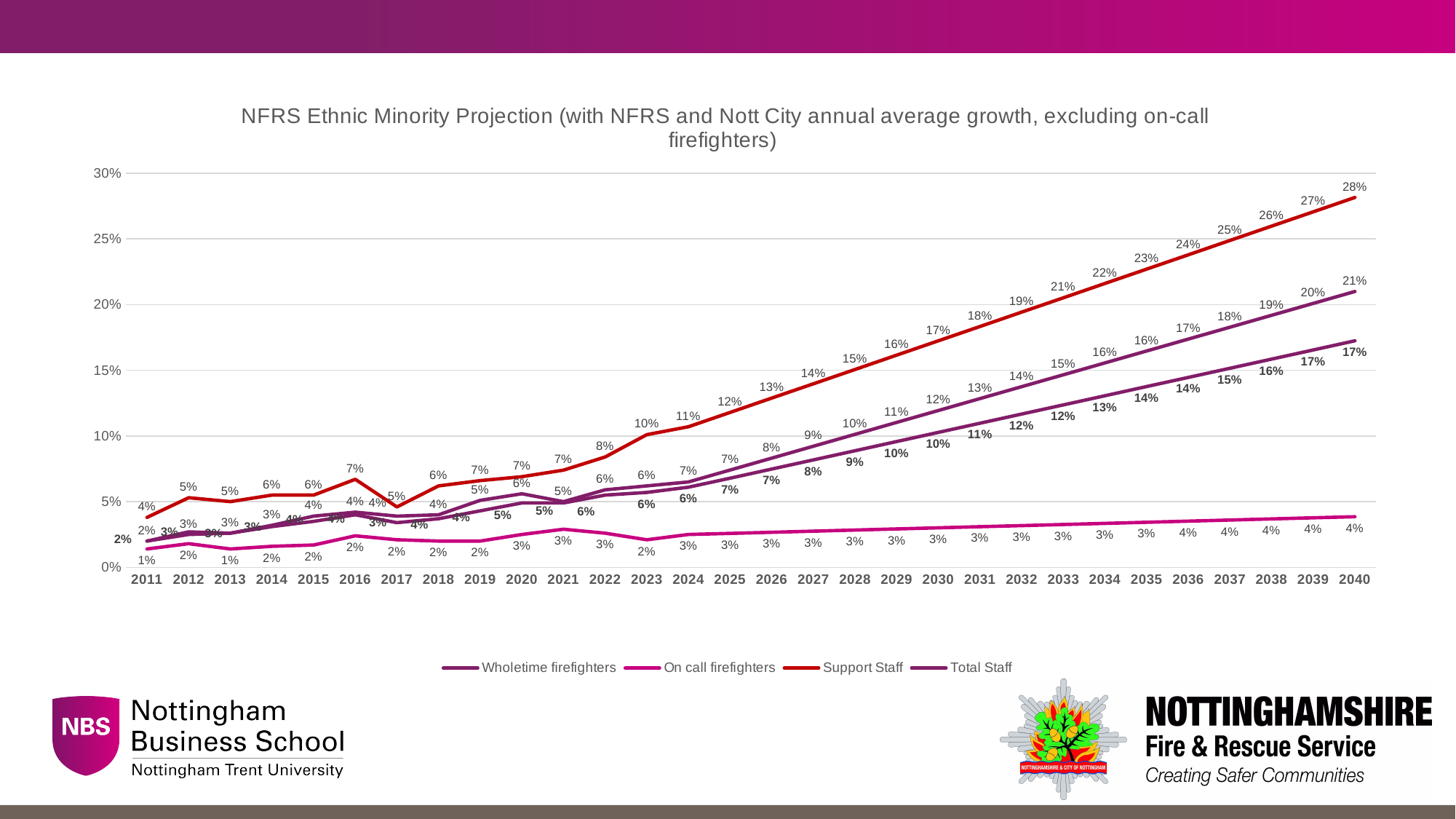
Which series has the highest value in 2040? Support Staff How many series does the legend list? 4 Does the Support Staff line rise or fall from 2011 to 2040? Rises By how many percentage points does the Support Staff value in 2040 exceed its value in 2011? 24 percentage points What is the Support Staff value in 2011? 4% What is the Support Staff value in 2040? 28% How many years are shown on the x axis? 30 What is the On call firefighters value in 2040? 4% What is the Support Staff value in 2023? 10% Which series has the lowest value in 2040? On call firefighters What kind of chart is shown on the slide? Line chart What is the On call firefighters value in 2011? 1%